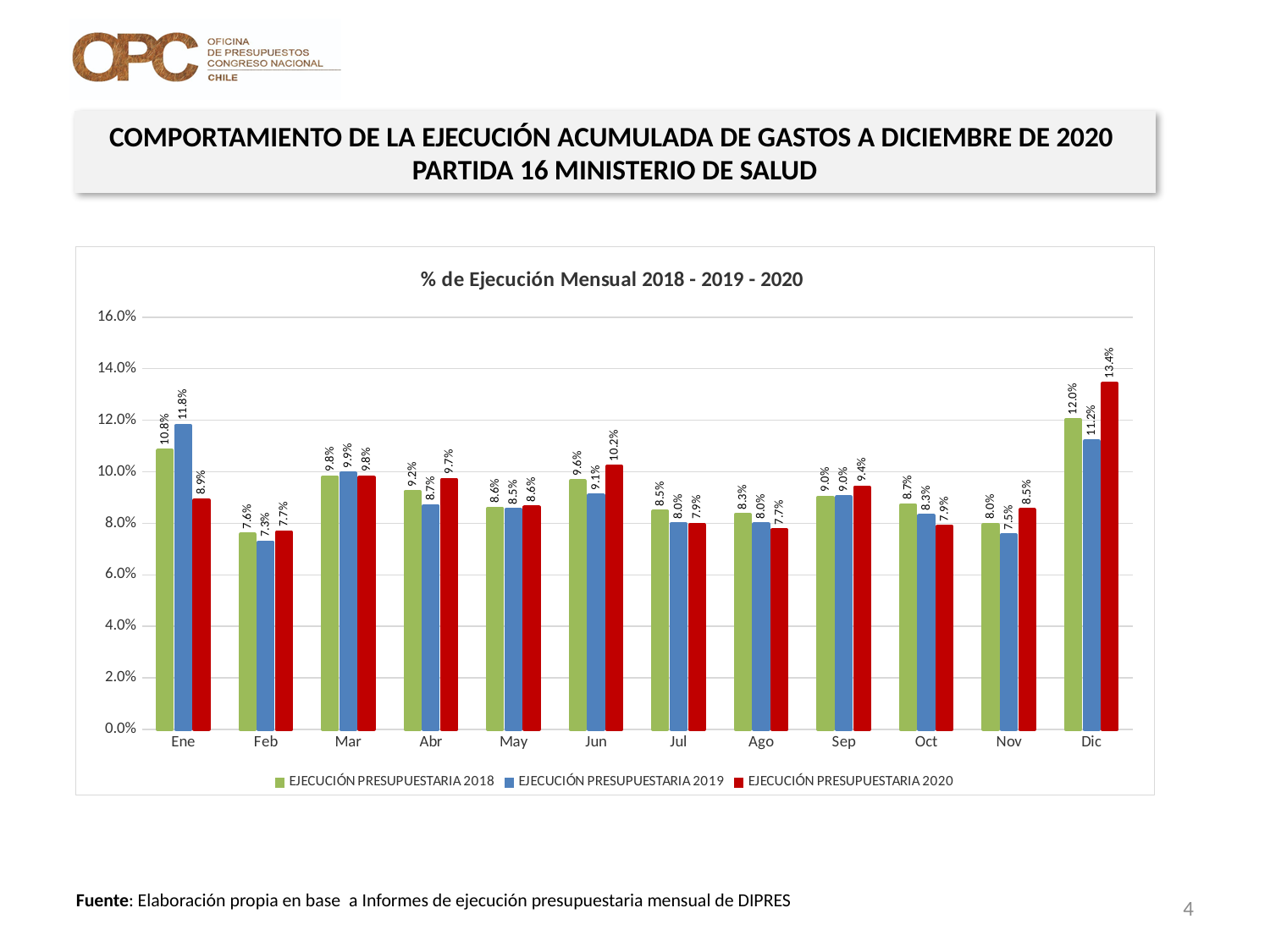
Which month has the lowest value for EJECUCIÓN PRESUPUESTARIA 2019? Feb How many months are shown on the x axis? 12 How many series does the legend list? 3 What is the title of the chart? % de Ejecución Mensual 2018 - 2019 - 2020 Which month has the highest value for EJECUCIÓN PRESUPUESTARIA 2020? Dic What is the value for EJECUCIÓN PRESUPUESTARIA 2018 in Jun? 9.6% What is the difference between the EJECUCIÓN PRESUPUESTARIA 2020 and EJECUCIÓN PRESUPUESTARIA 2019 values in Dic? 2.2% What kind of chart is shown? Bar chart What is the value for EJECUCIÓN PRESUPUESTARIA 2020 in Dic? 13.4% Which is larger in Ene: EJECUCIÓN PRESUPUESTARIA 2019 or EJECUCIÓN PRESUPUESTARIA 2020? EJECUCIÓN PRESUPUESTARIA 2019 Is the value for EJECUCIÓN PRESUPUESTARIA 2020 in Jun greater or less than 10.0%? greater What is the value for EJECUCIÓN PRESUPUESTARIA 2019 in Ene? 11.8%